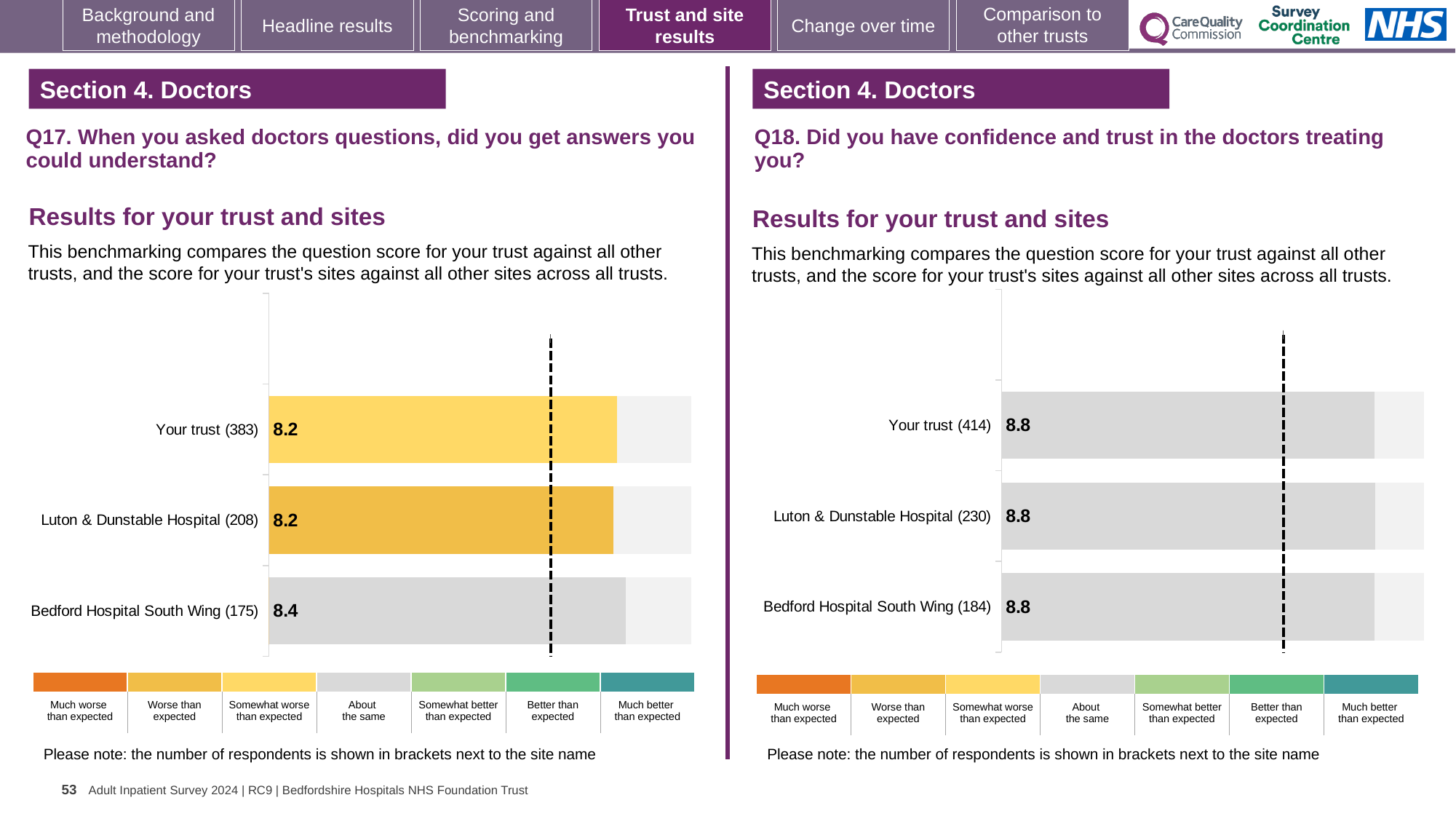
In the Q17 chart on the left, what is the score for Your trust (383)? 8.2 In the Q17 chart on the left, which benchmark category does the colour of the Luton & Dunstable Hospital (208) bar correspond to in the legend? Worse than expected In the Q17 chart on the left, what is the score for Luton & Dunstable Hospital (208)? 8.2 In the Q18 chart on the right, what is the score for Your trust (414)? 8.8 In the Q18 chart on the right, what is the score for Bedford Hospital South Wing (184)? 8.8 In the Q17 chart on the left, which site or trust has the highest score? Bedford Hospital South Wing (175) In the Q18 chart on the right, what is the difference between the score for Your trust (414) and the score for Luton & Dunstable Hospital (230)? 0 What kind of chart is used in the Q18 chart on the right? Bar chart In the Q17 chart on the left, what is the score for Bedford Hospital South Wing (175)? 8.4 In the Q17 chart on the left, how many bars are plotted? 3 In the Q18 chart on the right, how many categories does the colour legend below the chart list? 7 In the Q17 chart on the left, what is the difference between the score for Bedford Hospital South Wing (175) and the score for Luton & Dunstable Hospital (208)? 0.2